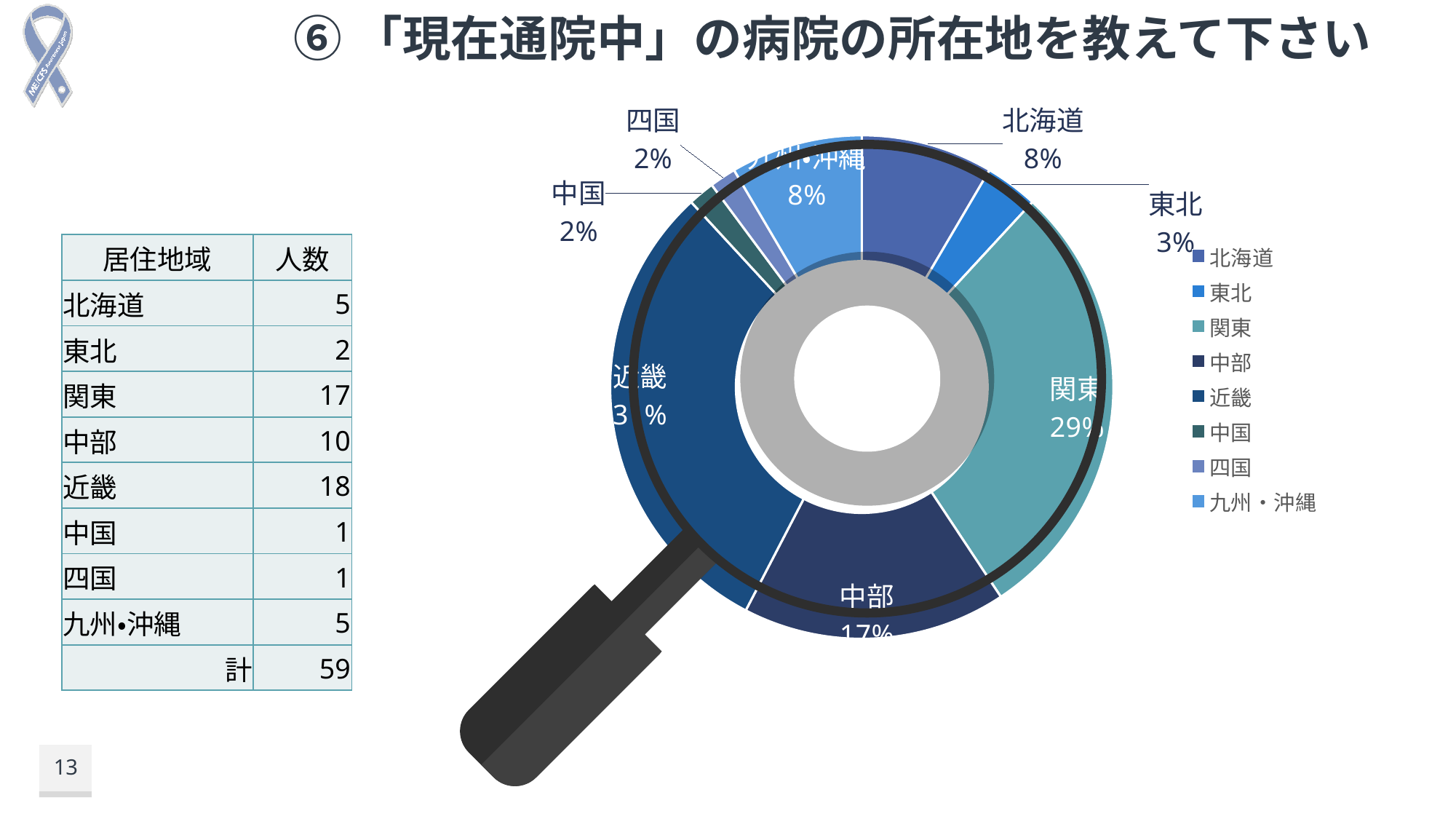
What percentage is shown for 東北 in the pie chart? 3% How many entries does the chart legend list? 8 What is the difference in percentage points between 関東 and 中部 in the pie chart? 12 How many categories (slices) does the pie chart have? 8 What is the value shown for 中部 in the pie chart? 17% What percentage is shown for 四国 in the pie chart? 2% What percentage of the pie chart does 関東 represent? 29% Which slice is larger in the pie chart, 関東 or 中部? 関東 What percentage is shown for 北海道 in the pie chart? 8% Which slice is larger in the pie chart, 北海道 or 東北? 北海道 What percentage is shown for 九州・沖縄 in the pie chart? 8% What kind of chart is shown on the slide? Doughnut chart